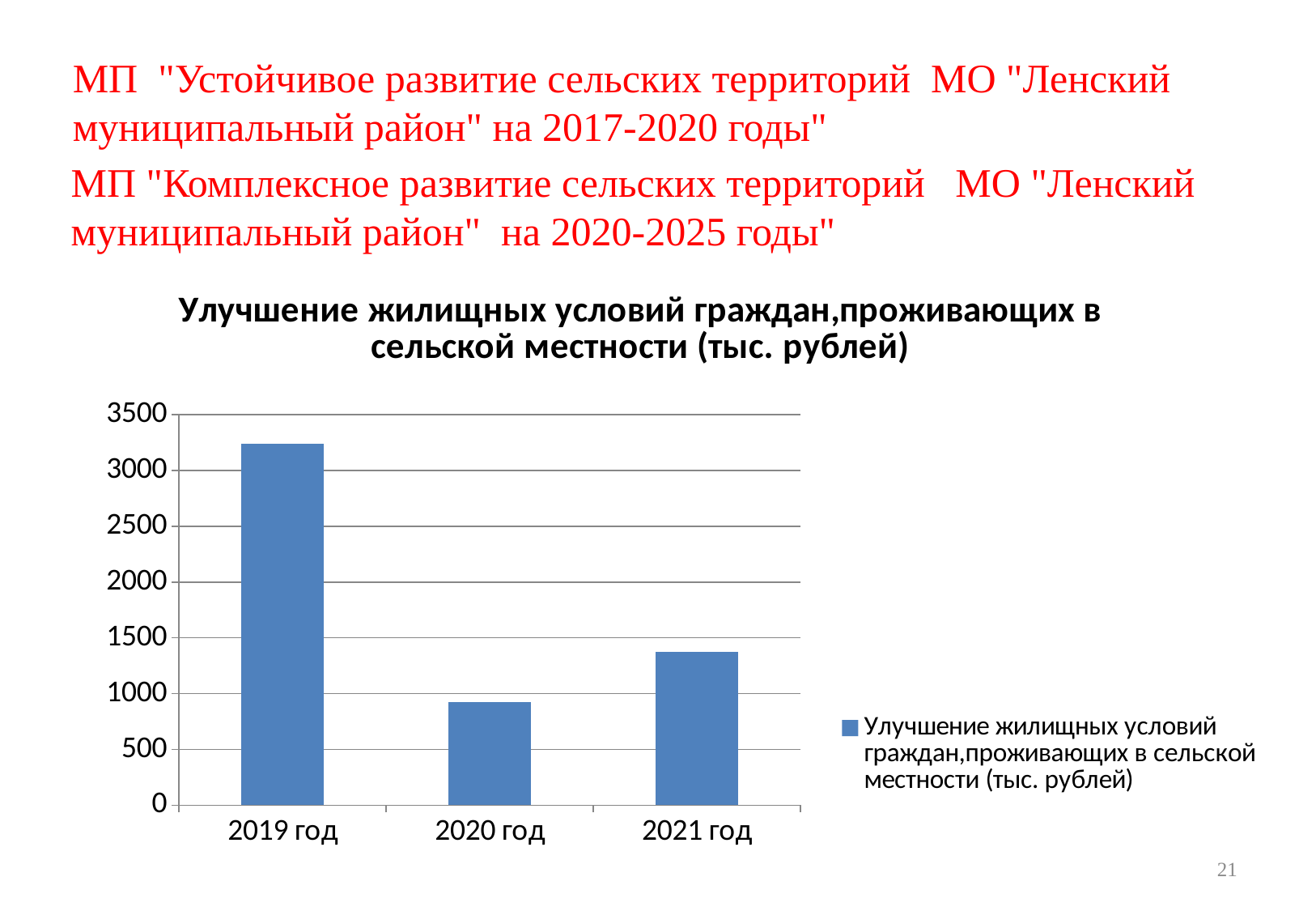
Which year has the highest value in the chart? 2019 год Does the value rise or fall from 2019 год to 2020 год? fall What kind of chart is shown on the slide? bar chart Is the value for 2020 год greater or less than 1000? less Is the value for 2019 год greater or less than 3000? greater Which is larger, the value for 2021 год or the value for 2020 год? 2021 год What is the title of the chart? Улучшение жилищных условий граждан,проживающих в сельской местности (тыс. рублей) Which year has the lowest value in the chart? 2020 год Is the value for 2021 год greater or less than 1000? greater How many categories (years) are shown on the x axis of the chart? 3 How many series does the legend of the chart list? 1